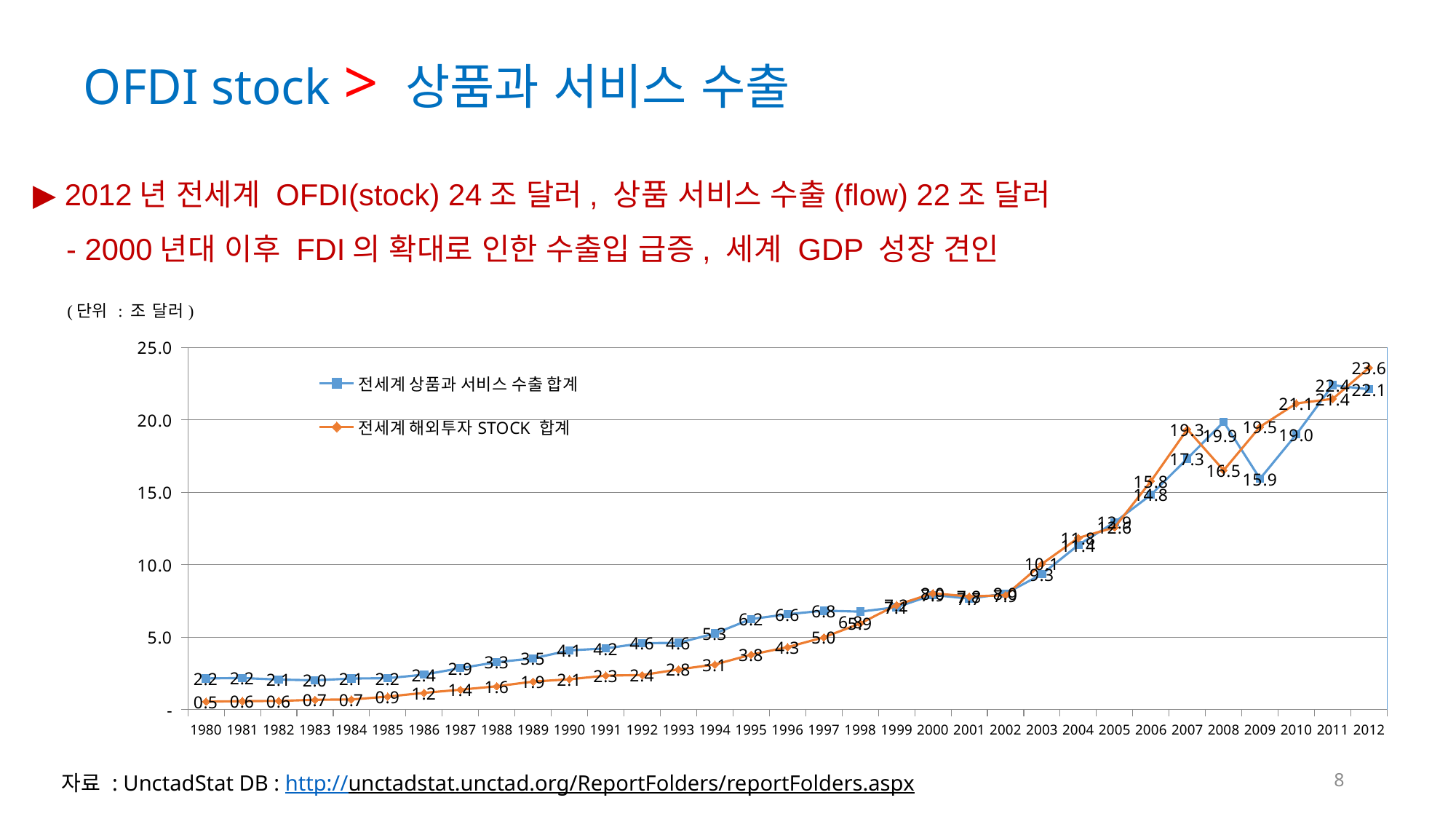
How many series does the chart legend list? 2 In 2009, which series has the larger value: 전세계 상품과 서비스 수출 합계 or 전세계 해외투자 STOCK 합계? 전세계 해외투자 STOCK 합계 What kind of chart is shown on the slide? line chart How many years are plotted along the x axis of the chart? 33 Overall, do the values of 전세계 해외투자 STOCK 합계 rise or fall from 1980 to 2012? rise What is the value of 전세계 상품과 서비스 수출 합계 in 2012? 22.1 What is the value of 전세계 해외투자 STOCK 합계 in 2012? 23.6 What is the value of 전세계 해외투자 STOCK 합계 in 1980? 0.5 What is the difference between 전세계 상품과 서비스 수출 합계 and 전세계 해외투자 STOCK 합계 in 2008? 3.4 In which year is 전세계 해외투자 STOCK 합계 lowest? 1980 In which year is 전세계 해외투자 STOCK 합계 highest? 2012 What is the value of 전세계 상품과 서비스 수출 합계 in 2009? 15.9